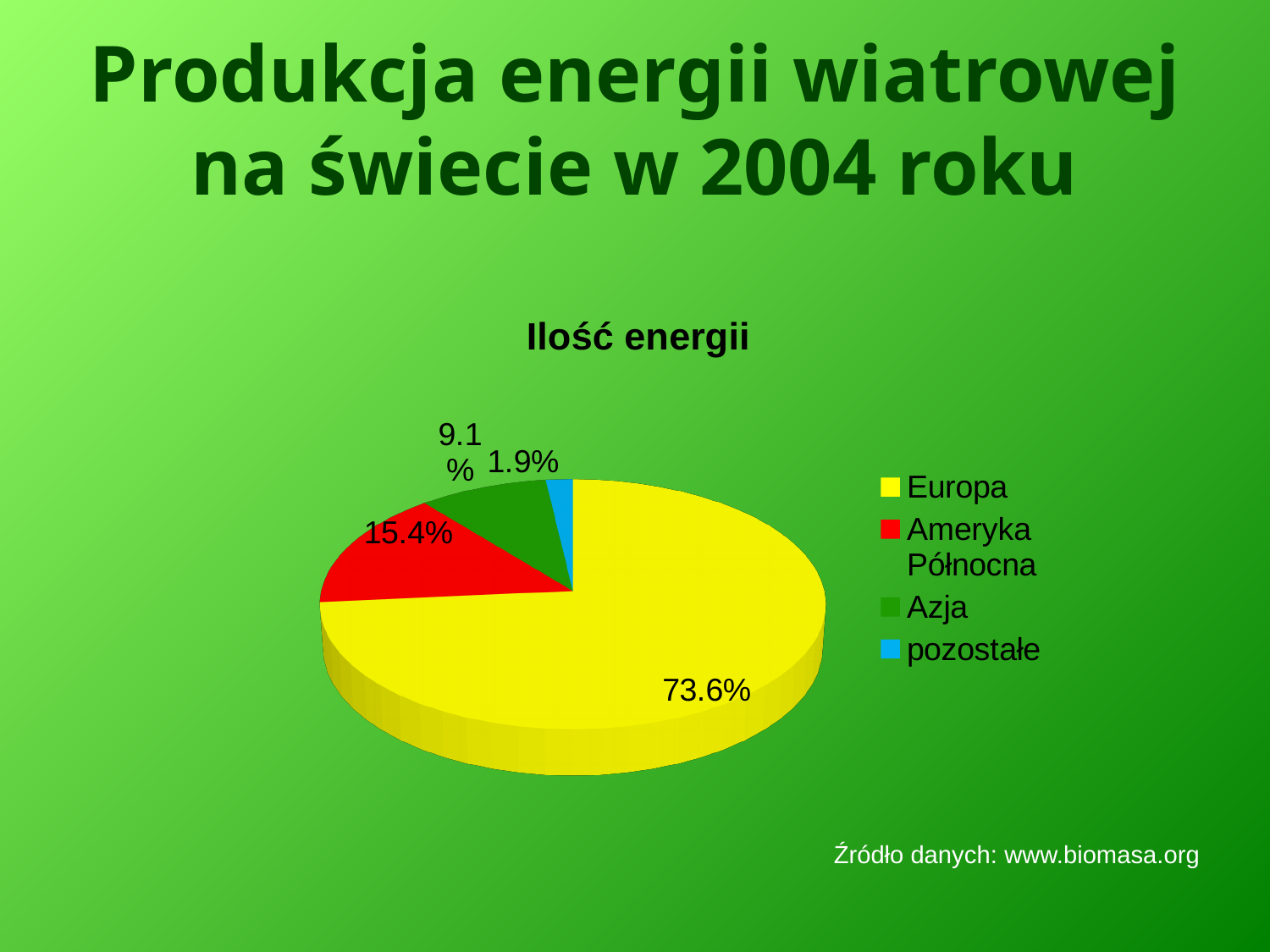
Which has a larger share, Ameryka Północna or Azja? Ameryka Północna What share of the pie does Ameryka Północna have? 15.4% What is the title of the chart? Ilość energii Which category has the smallest slice of the pie? pozostałe What share of the pie does Europa have? 73.6% What kind of chart is shown on the slide? Pie chart What share of the pie does Azja have? 9.1% Which category has the largest slice of the pie? Europa What is the difference between the shares of Europa and Ameryka Północna? 58.2% What is the difference between the shares of Azja and pozostałe? 7.2% How many categories are shown in the pie chart? 4